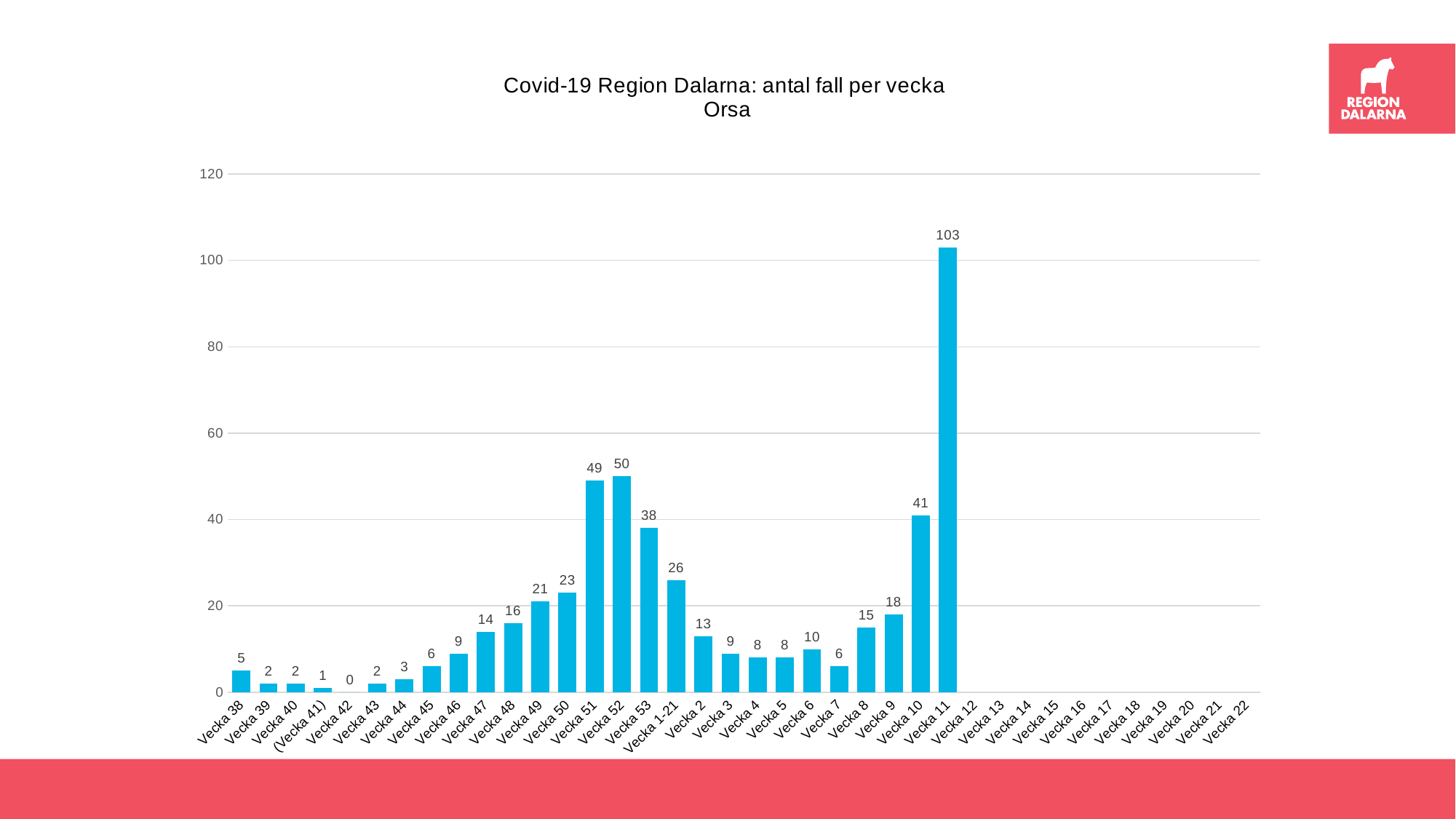
Is the value for Vecka 11 greater or less than 100? greater What is the difference between the values for Vecka 52 and Vecka 53? 12 Which is larger, the value for Vecka 51 or the value for Vecka 53? Vecka 51 What is the difference between the values for Vecka 11 and Vecka 10? 62 What is the value for Vecka 1-21? 26 Which week has the highest number of cases? Vecka 11 What is the value for Vecka 11? 103 What is the title of the chart? Covid-19 Region Dalarna: antal fall per vecka Orsa Which week has the lowest number of cases? Vecka 42 Do the values rise or fall from Vecka 43 to Vecka 52? rise What is the value for Vecka 52? 50 What kind of chart is shown on the slide? bar chart